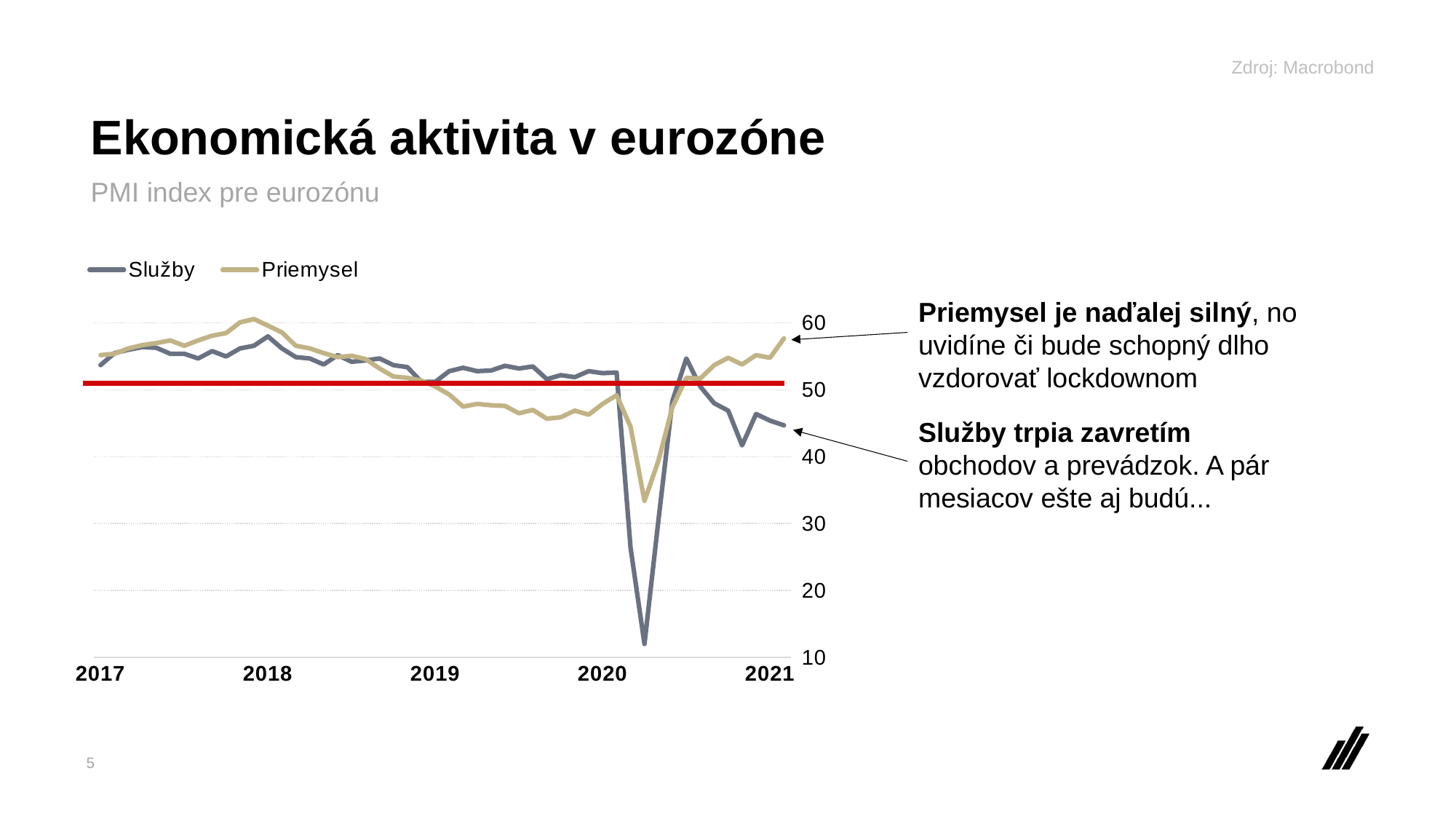
Which series reaches the lowest value anywhere on the chart? Služby Is the value of the Služby series at the start of 2021 greater or less than 50? less Is the lowest value of the Služby series in 2020 greater or less than 20? less What is the title of the chart on the slide? Ekonomická aktivita v eurozóne What are the two series named in the chart legend? Služby and Priemysel How many year labels are shown on the x axis? 5 Does the Priemysel series rise or fall between mid-2020 and the start of 2021? rise What kind of chart is shown on the slide? line chart Is the value of the Priemysel series at the start of 2021 greater or less than 50? greater How many series does the chart legend list? 2 Which series is higher at the start of 2021, Služby or Priemysel? Priemysel